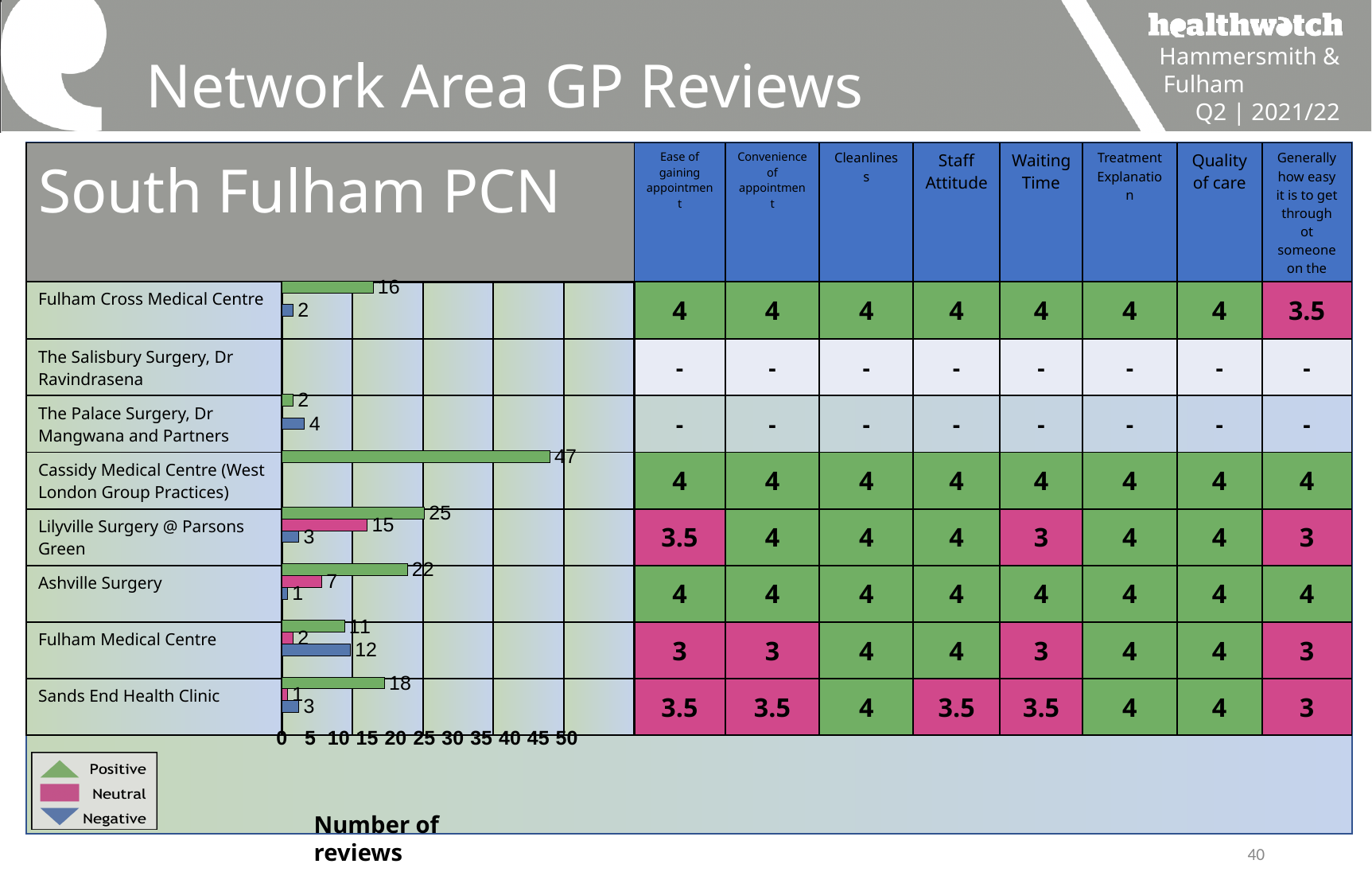
How many negative reviews does Fulham Medical Centre have? 12 What is the total number of reviews (positive, neutral and negative) for Ashville Surgery? 30 How many positive reviews does Sands End Health Clinic have? 18 Which practice has the highest number of positive reviews? Cassidy Medical Centre (West London Group Practices) What is the difference between the positive reviews for Lilyville Surgery @ Parsons Green and Ashville Surgery? 3 Which is larger for Fulham Medical Centre: the number of positive reviews or the number of negative reviews? Negative reviews How many series does the legend of the reviews chart list? 3 How many positive reviews does Cassidy Medical Centre (West London Group Practices) have? 47 What type of chart is used to show the number of reviews on the slide? Bar chart What is the label on the horizontal axis of the reviews chart? Number of reviews What are the three series named in the legend of the reviews chart? Positive, Neutral, Negative How many neutral reviews does Lilyville Surgery @ Parsons Green have? 15